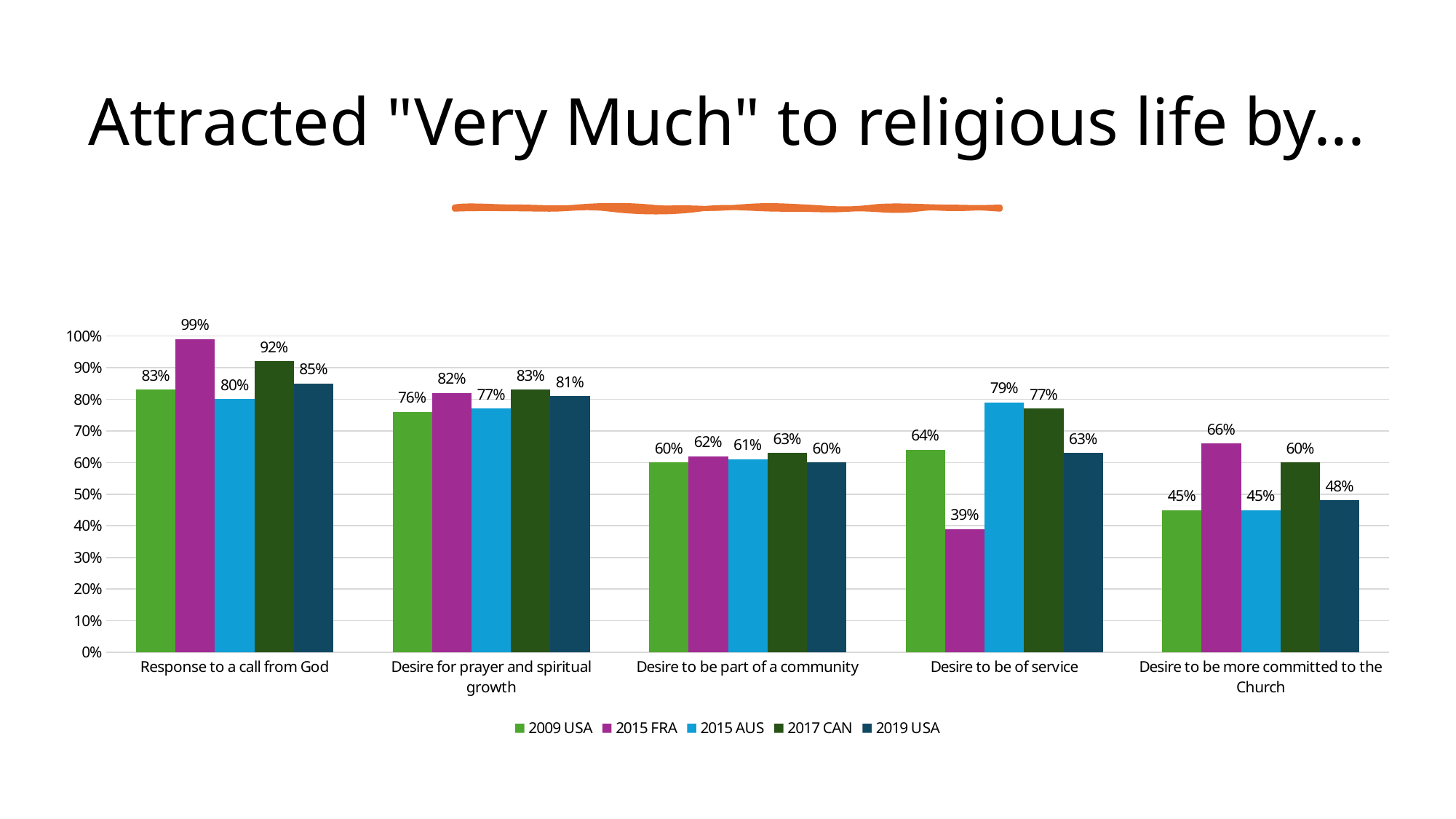
How many series does the legend list? 5 What is the value for 2015 AUS in the 'Desire to be of service' category? 79% Which series has the highest value in the 'Response to a call from God' category? 2015 FRA What kind of chart is shown on the slide? Bar chart Which is larger in the 'Desire for prayer and spiritual growth' category: 2017 CAN or 2009 USA? 2017 CAN Which series has the lowest value in the 'Desire to be of service' category? 2015 FRA What is the value for 2017 CAN in the 'Desire to be more committed to the Church' category? 60% What is the title of the chart on the slide? Attracted "Very Much" to religious life by... What is the value for 2015 FRA in the 'Response to a call from God' category? 99% How many categories are shown on the x axis? 5 What is the difference between the 2015 FRA and 2009 USA values in the 'Desire to be more committed to the Church' category? 21% What is the difference between the 2015 AUS and 2015 FRA values in the 'Desire to be of service' category? 40%